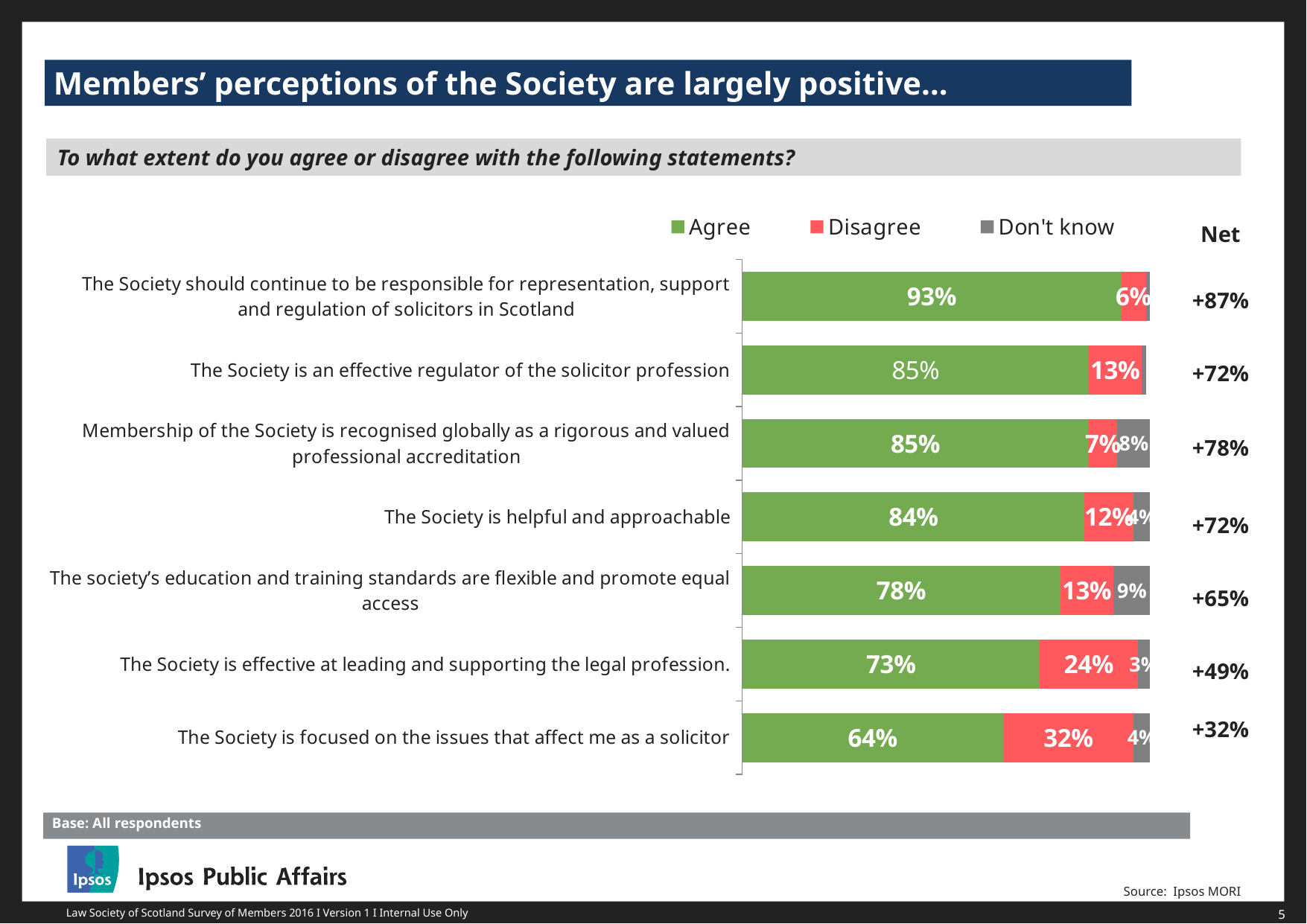
What percentage of members agree that the Society should continue to be responsible for representation, support and regulation of solicitors in Scotland? 93% Which statement has the lowest Agree percentage? The Society is focused on the issues that affect me as a solicitor What percentage of members disagree that the Society is focused on the issues that affect them as a solicitor? 32% Which statement has the highest Agree percentage? The Society should continue to be responsible for representation, support and regulation of solicitors in Scotland How many statements are shown in the chart? 7 What is the difference between the Agree percentage for 'The Society is helpful and approachable' and the Agree percentage for 'The Society is focused on the issues that affect me as a solicitor'? 20% What is the Net score shown for 'The society's education and training standards are flexible and promote equal access'? +65% How many series does the legend list? 3 What kind of chart is shown on the slide? Stacked bar chart What percentage of members disagree that the Society is effective at leading and supporting the legal profession? 24% Which colour represents the Disagree series in the chart? Red Which has a larger Disagree percentage: 'The Society is an effective regulator of the solicitor profession' or 'The Society is effective at leading and supporting the legal profession'? The Society is effective at leading and supporting the legal profession